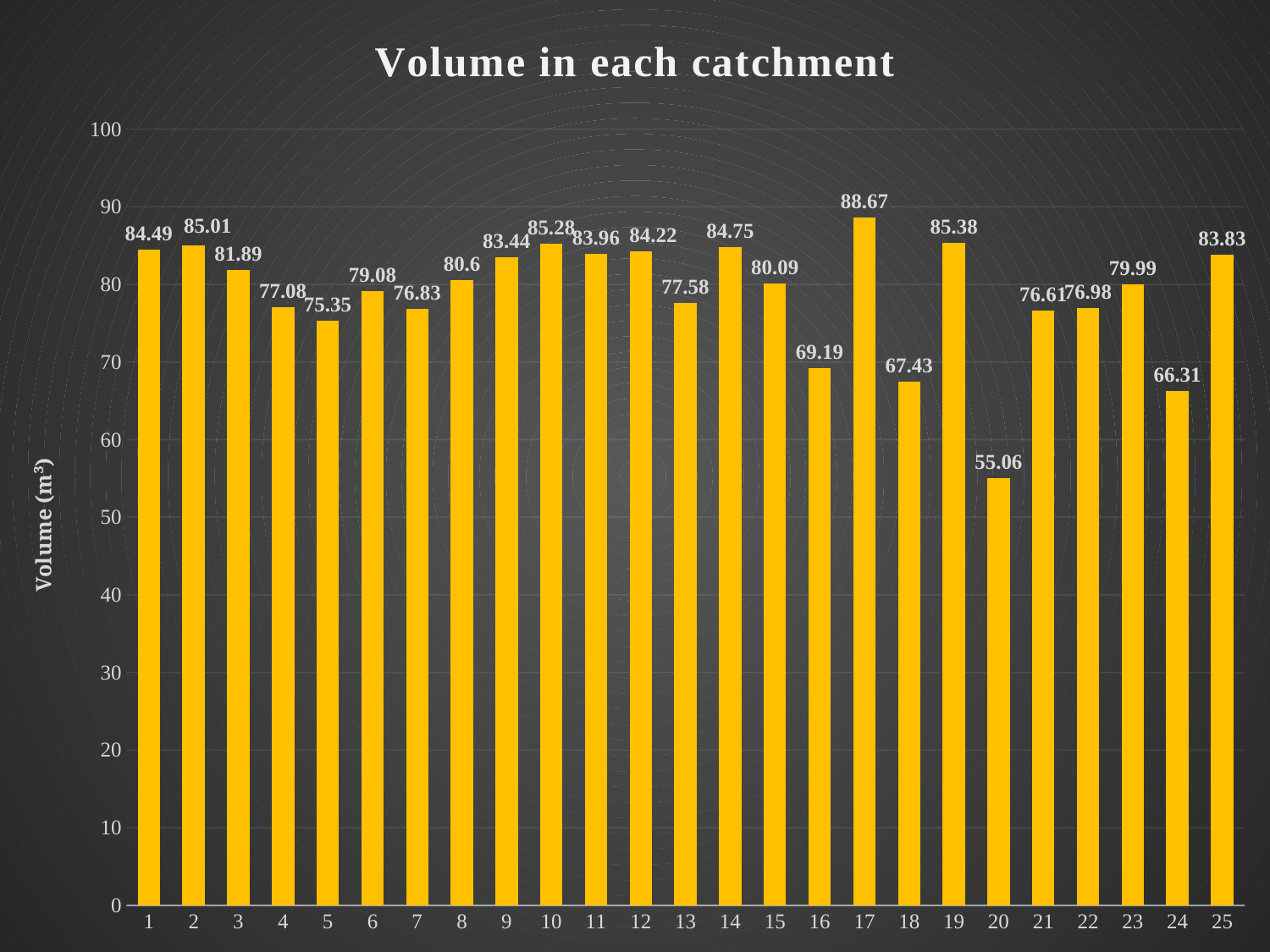
What is the volume for catchment 17? 88.67 What is the title of the vertical axis? Volume (m³) Is the value for catchment 20 greater or less than 60? less What is the volume for catchment 8? 80.6 What kind of chart is shown on the slide? Bar chart How many catchments are shown on the chart? 25 Which catchment has the highest volume? 17 What is the difference between the volumes of catchment 17 and catchment 20? 33.61 Which has a larger volume, catchment 3 or catchment 4? Catchment 3 Which catchment has the lowest volume? 20 What is the difference between the volumes of catchment 16 and catchment 18? 1.76 What is the volume for catchment 20? 55.06